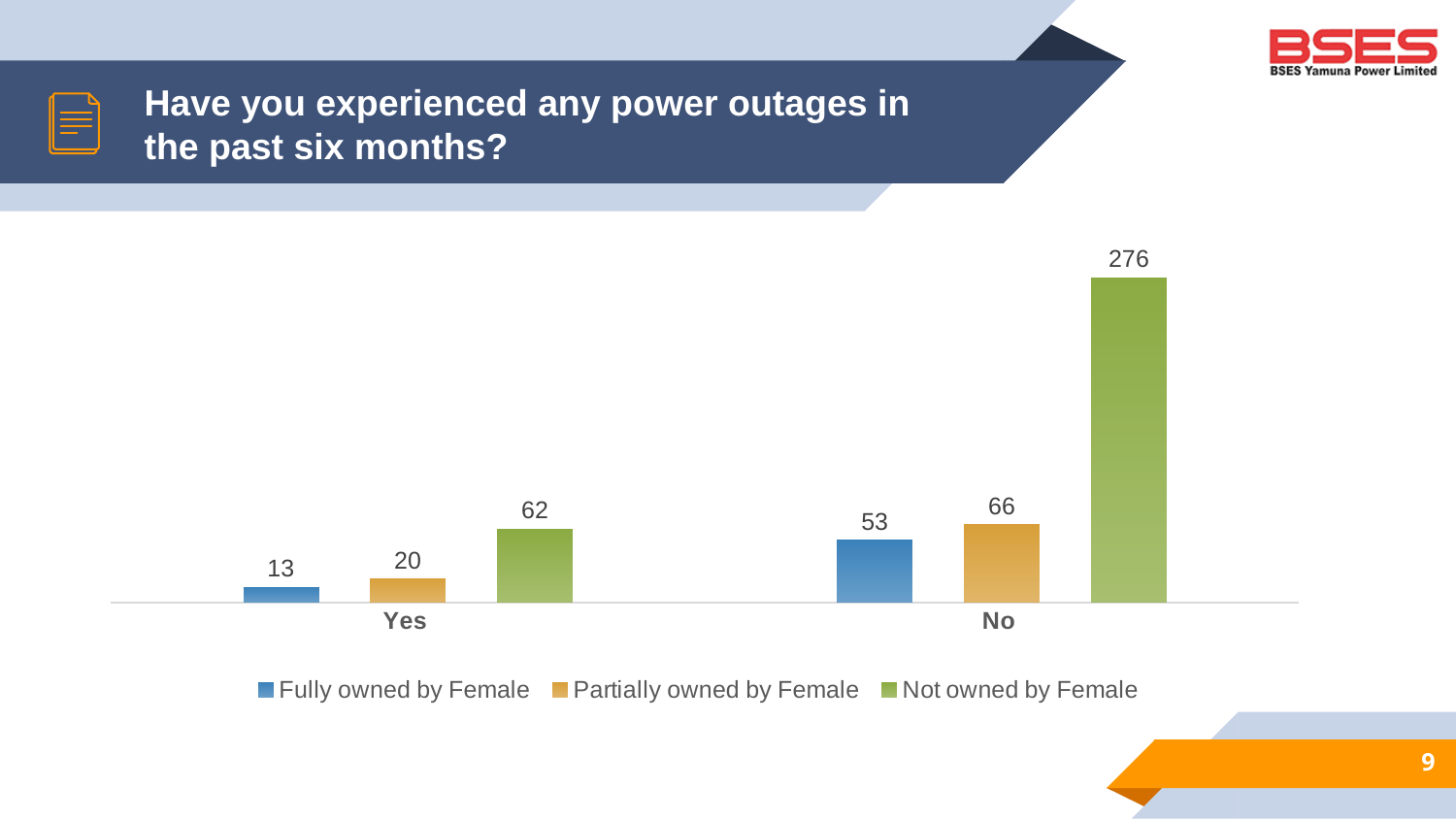
Which series has the lowest value in the 'Yes' category? Fully owned by Female What is the difference between the 'Not owned by Female' values for 'No' and 'Yes'? 214 Which series has the highest value in the 'No' category? Not owned by Female How many categories are shown on the x axis? 2 What is the value for 'Partially owned by Female' in the 'No' category? 66 How many series does the legend list? 3 What is the value for 'Fully owned by Female' in the 'Yes' category? 13 What is the value for 'Not owned by Female' in the 'No' category? 276 What colour are the bars for 'Partially owned by Female'? Orange What is the value for 'Not owned by Female' in the 'Yes' category? 62 What kind of chart is shown on the slide? Bar chart Which is larger: 'Partially owned by Female' for 'Yes' or 'Fully owned by Female' for 'No'? Fully owned by Female for No